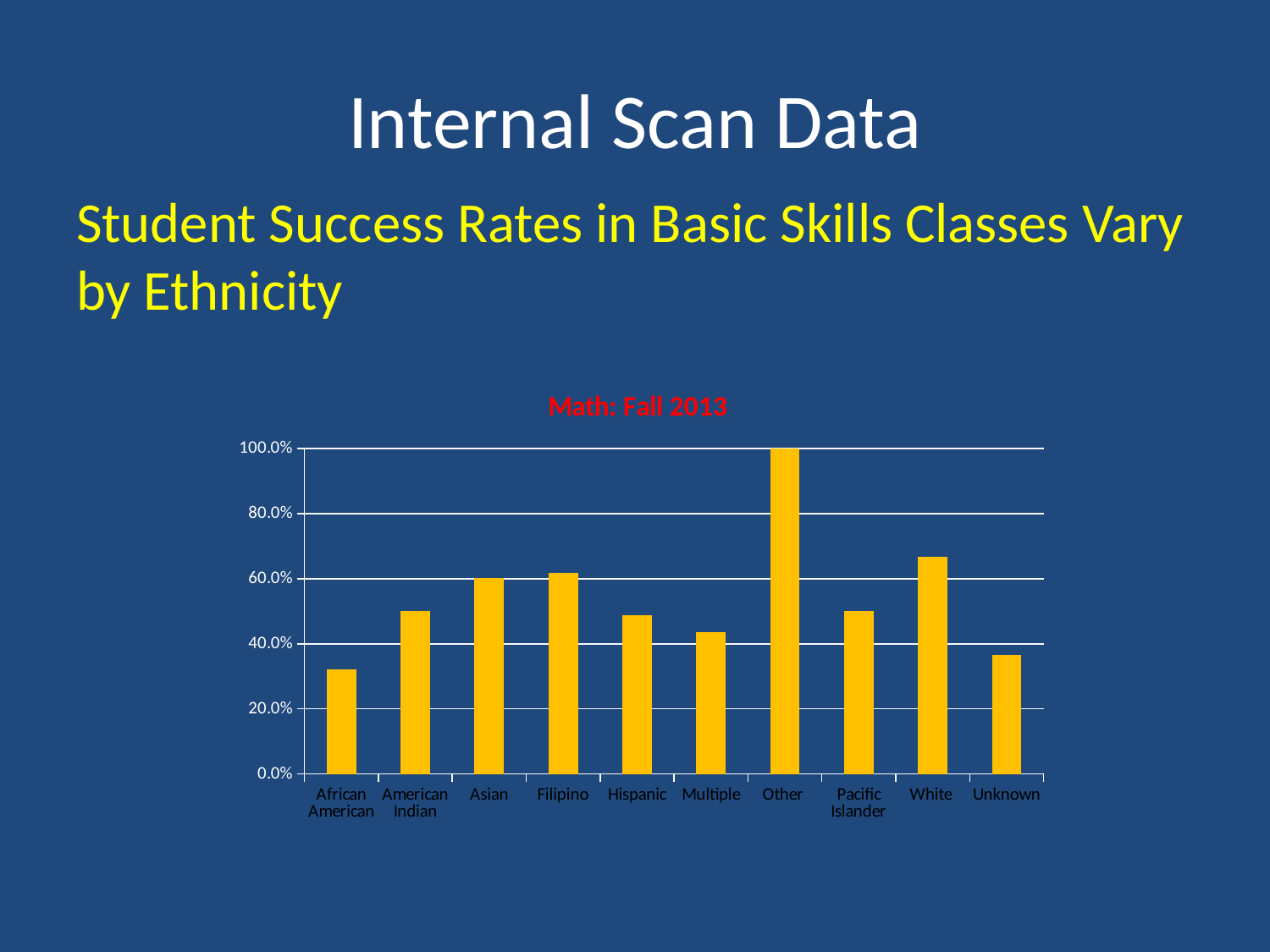
Which is larger, the value for Unknown or the value for Asian? Asian What is the success rate for Other in the Math: Fall 2013 chart? 100.0% Is the value for Multiple greater or less than 60.0%? less Which category has the lowest success rate in the Math: Fall 2013 chart? African American How many ethnicity categories are plotted in the Math: Fall 2013 chart? 10 Which is larger, the value for White or the value for Hispanic? White Is the value for Filipino greater or less than 40.0%? greater What is the title of the chart? Math: Fall 2013 Which category has the highest success rate in the Math: Fall 2013 chart? Other Is the value for White greater or less than 60.0%? greater What kind of chart is shown on the slide? bar chart